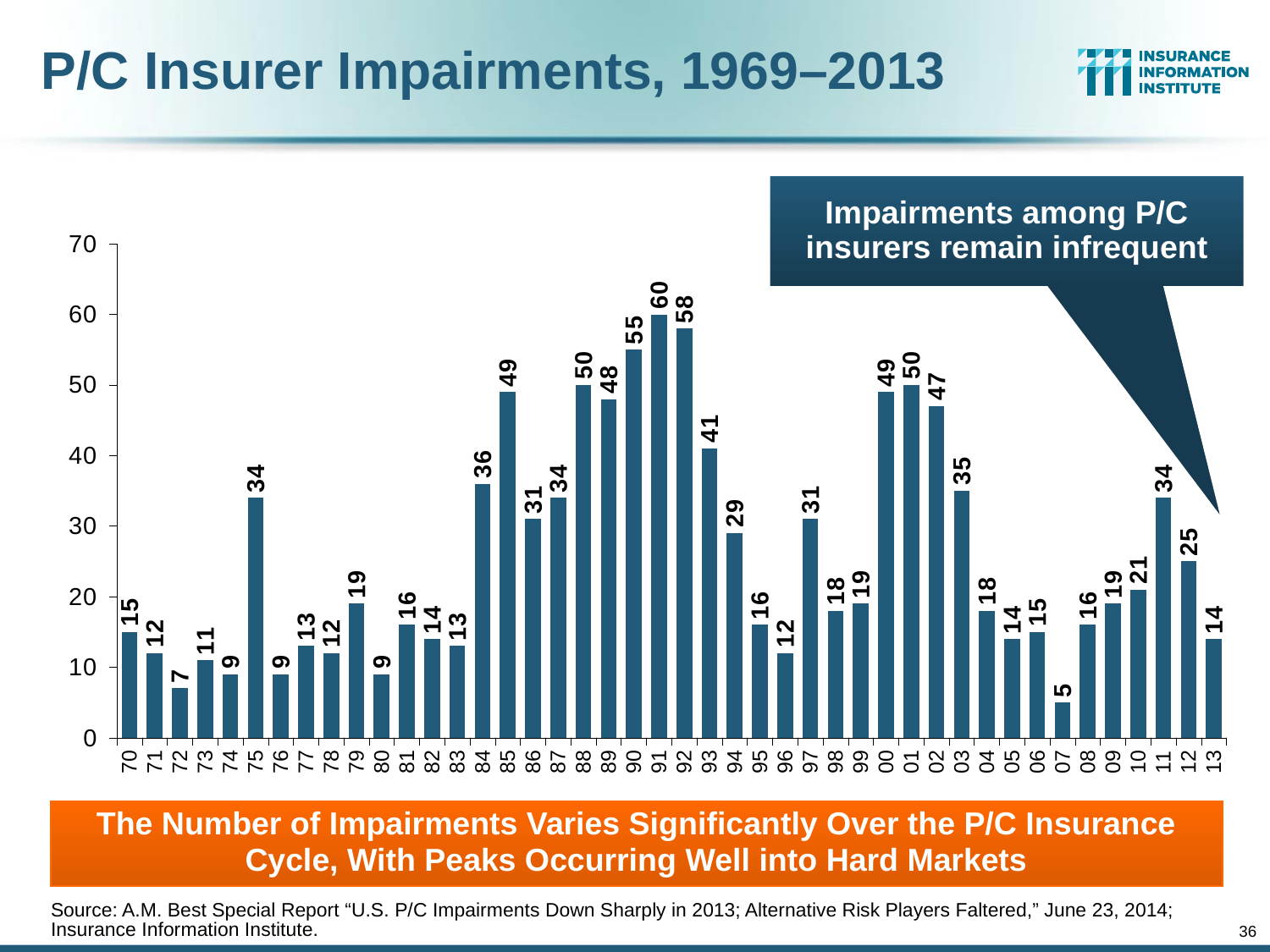
What is the difference between the values for 2012 (12) and 2013 (13)? 11 Which year has the lowest number of impairments? 07 What is the number of P/C insurer impairments shown for 1991 (labelled 91)? 60 What kind of chart is shown on the slide? Bar chart How many years (bars) are plotted on the chart? 44 What is the value shown for 2007 (labelled 07)? 5 Which is larger, the value for 2000 (00) or the value for 2001 (01)? 01 What is the value shown for 2013 (labelled 13)? 14 Which year has the highest number of impairments? 91 Is the value for 1985 (85) greater or less than 40? greater Do the values rise or fall from 2011 (11) to 2013 (13)? Fall What is the difference between the values for 1991 (91) and 1992 (92)? 2